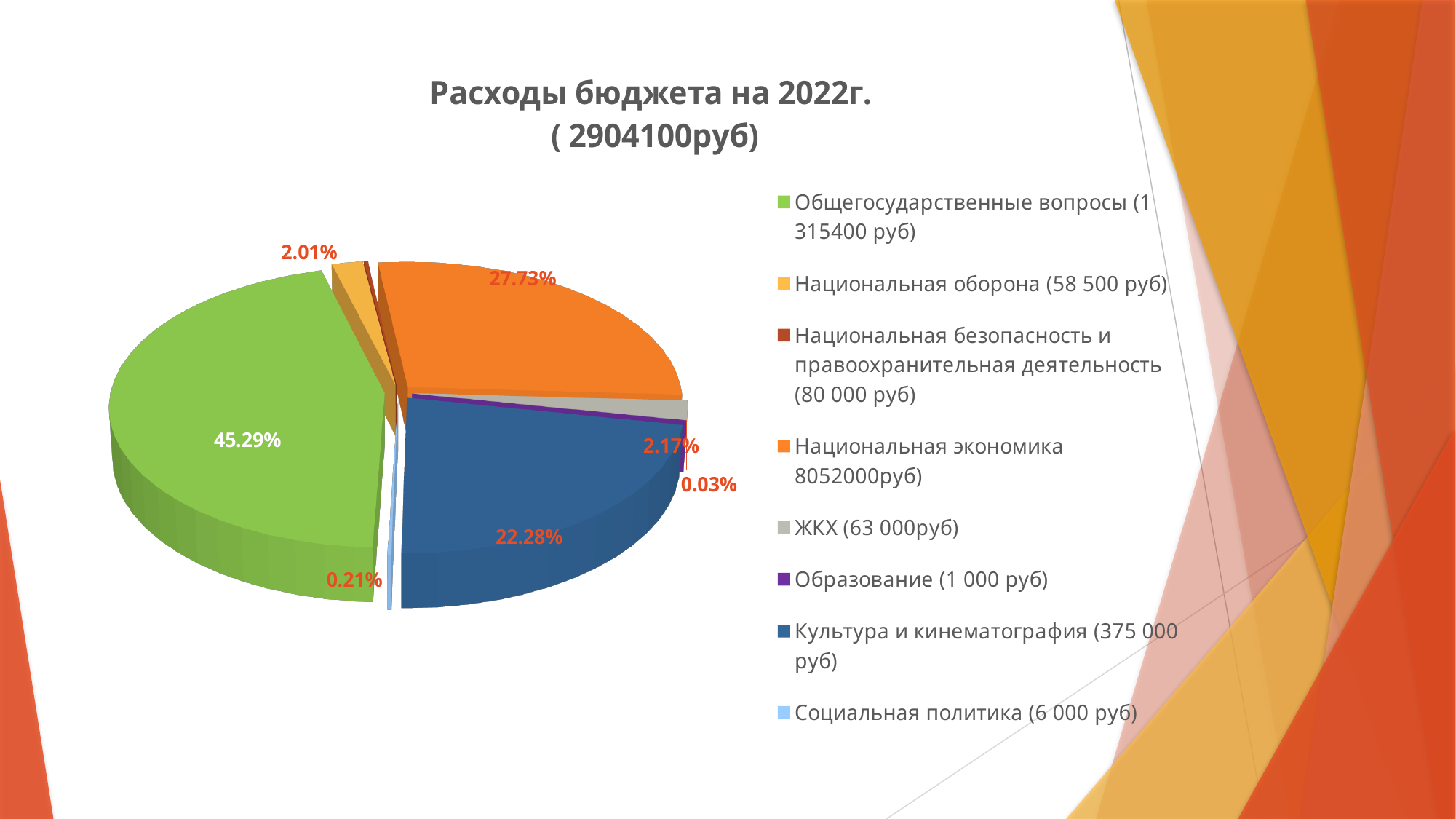
What share of the pie is labelled for Общегосударственные вопросы? 45.29% What share of the pie is labelled for ЖКХ? 2.17% Which category has the largest share of the pie? Общегосударственные вопросы What share of the pie is labelled for Социальная политика? 0.21% What kind of chart is shown on the slide? Pie chart Which share is larger: Национальная экономика or Культура и кинематография? Национальная экономика What is the difference in percentage points between the shares of Общегосударственные вопросы and Национальная экономика? 17.56 How many categories does the legend of the pie chart list? 8 What is the title of the chart? Расходы бюджета на 2022г. ( 2904100руб) Which category has the smallest labelled share of the pie? Образование